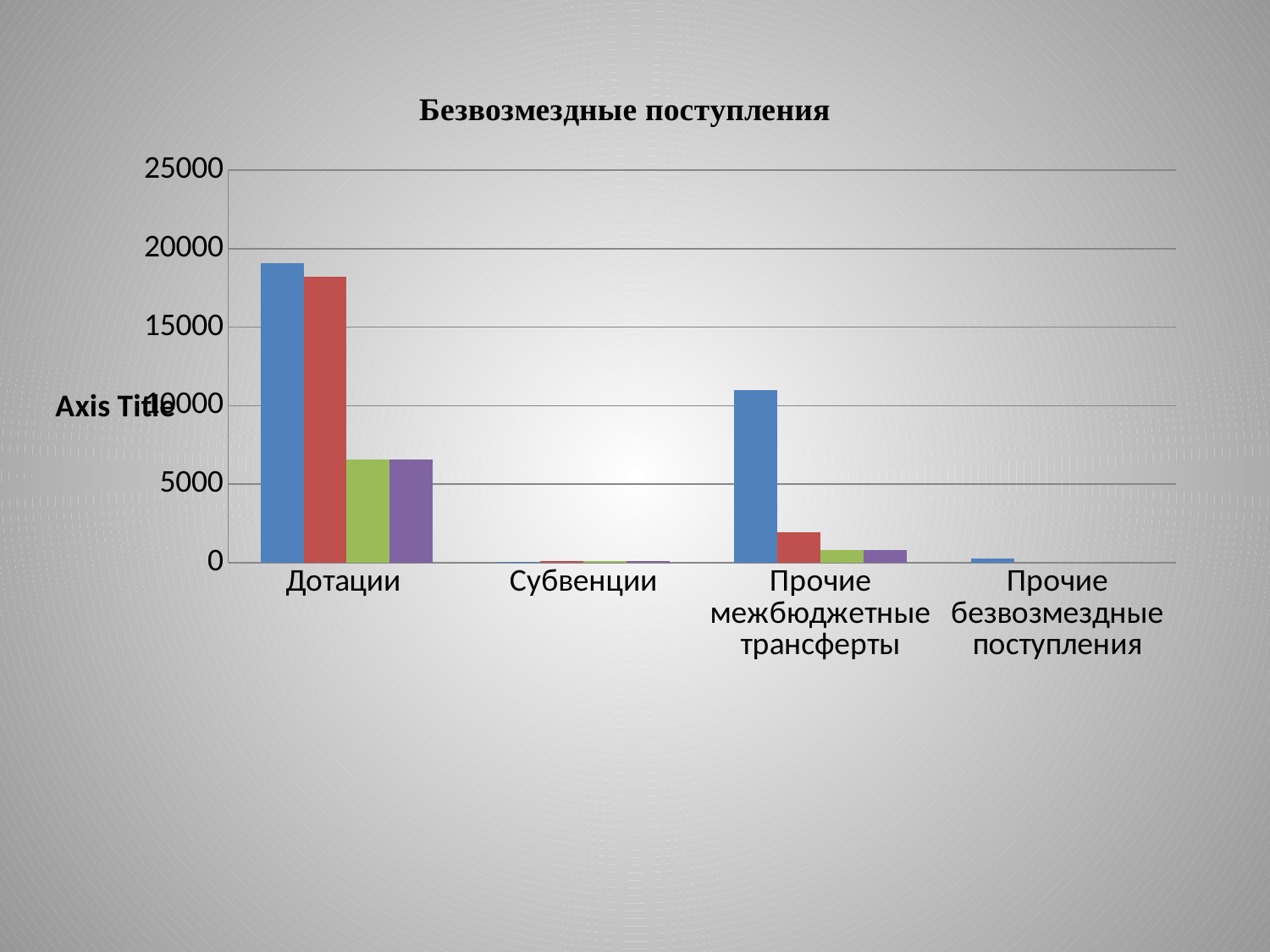
What is the highest value shown on the vertical axis of the chart? 25000 What type of chart is shown on the slide? bar chart Which category has the taller bars: Прочие межбюджетные трансферты or Субвенции? Прочие межбюджетные трансферты Is the tallest bar for Дотации greater or less than 15000? greater Is the tallest bar for Прочие межбюджетные трансферты greater or less than 10000? greater Which category has the taller bars: Дотации or Прочие безвозмездные поступления? Дотации Is the tallest bar for Прочие межбюджетные трансферты greater or less than 15000? less Which category has the tallest bar in the chart? Дотации What is the title of the chart? Безвозмездные поступления How many categories are shown on the x axis of the chart? 4